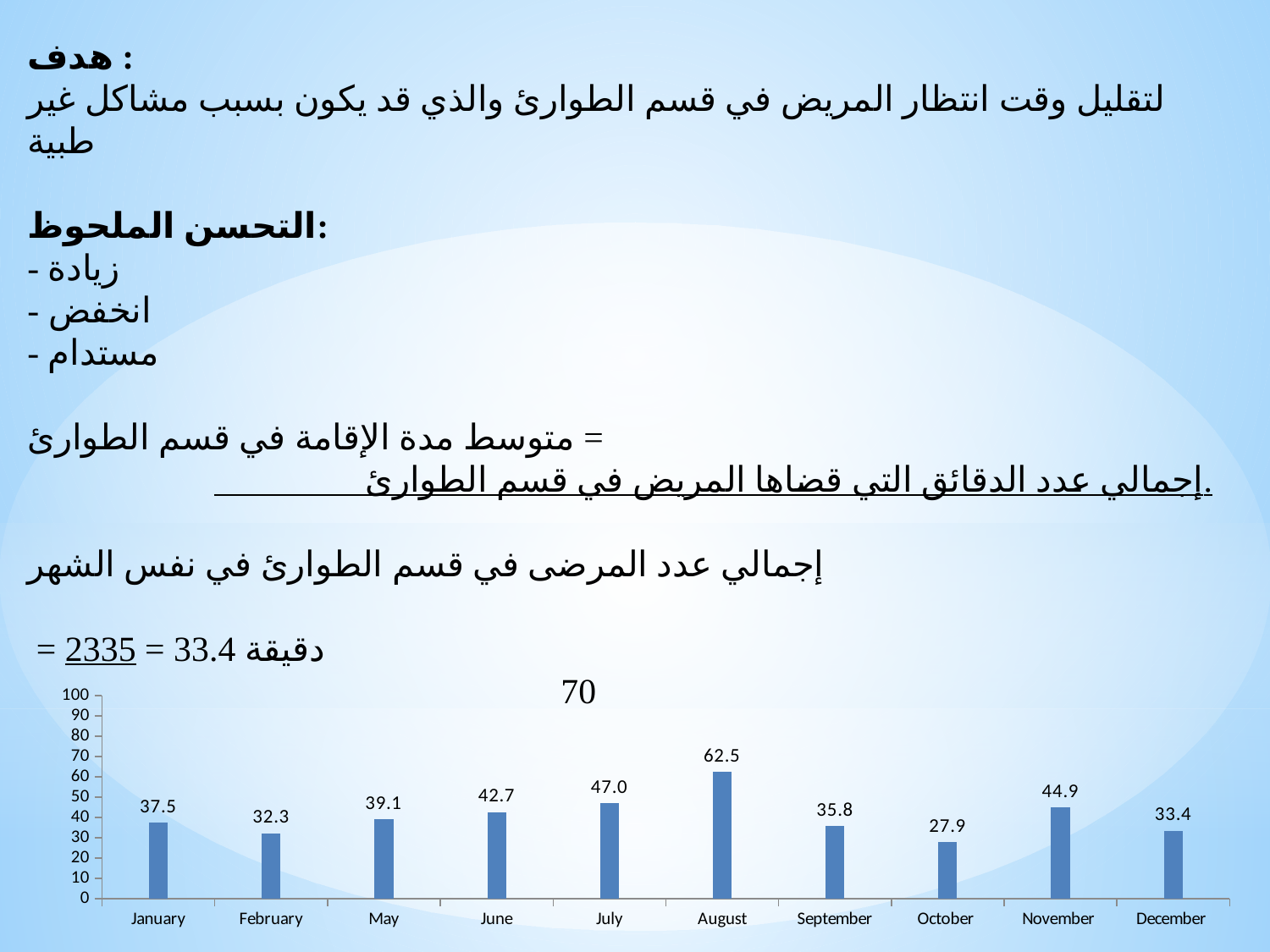
What is the value for October? 27.9 How many months are shown on the x axis? 10 Is the value for June greater or less than 40? greater Which is larger, the value for July or the value for November? July Which month has the highest value? August What kind of chart is shown on the slide? bar chart What is the value for January? 37.5 Do the values rise or fall from August to October? fall What is the value for August? 62.5 Which month has the lowest value? October What is the difference between the values for August and October? 34.6